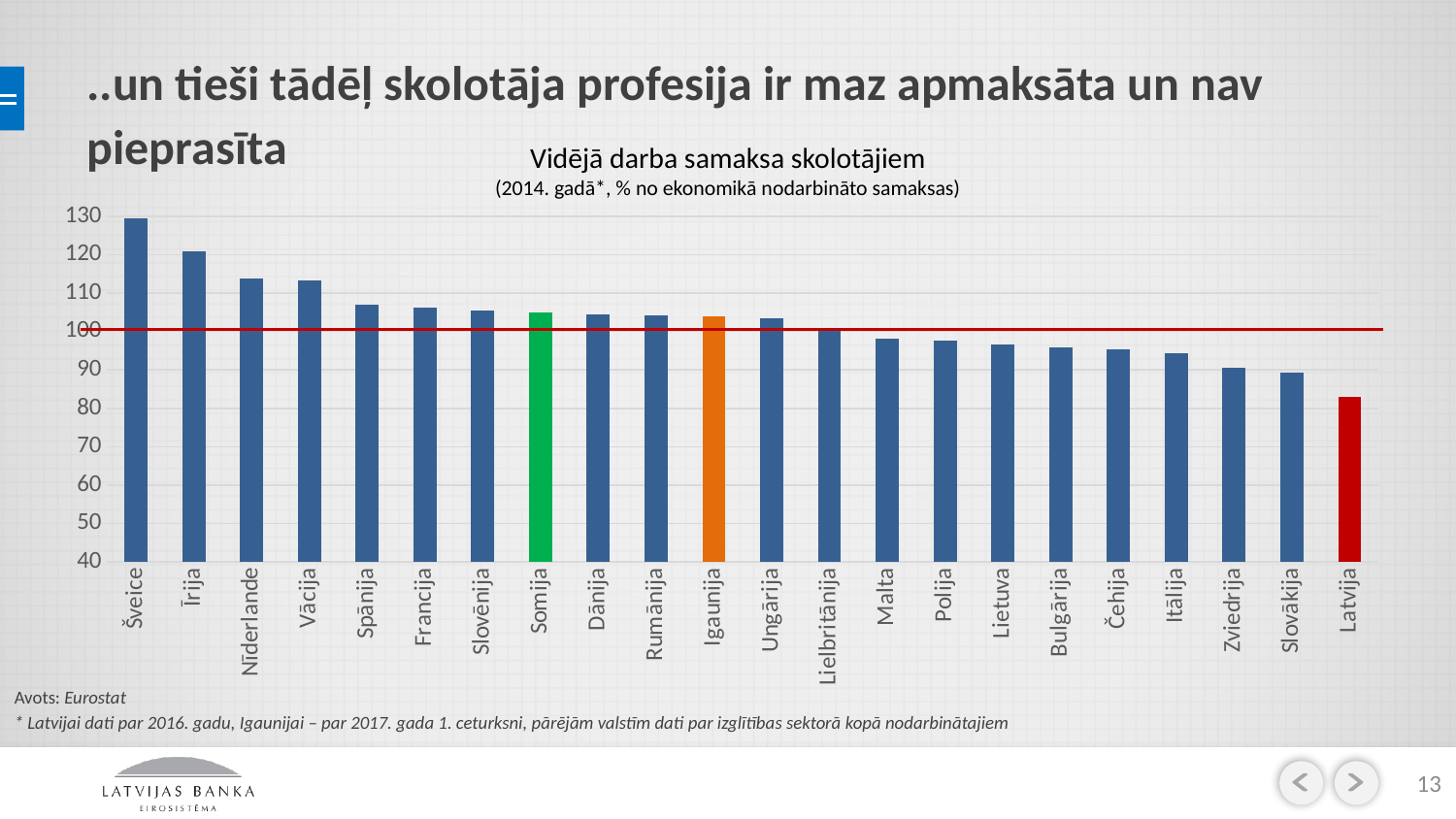
Do the values rise or fall from left to right along the x axis? fall What kind of chart is shown on the slide? bar chart How many countries are shown in the chart? 22 Which country has the highest value in the chart? Šveice Is the value for Šveice greater or less than 120? greater What colour is the bar for Latvija? red Which country has the lowest value in the chart? Latvija Which has a larger value, Īrija or Spānija? Īrija Is the value for Zviedrija greater or less than 100? less Is the value for Vācija greater or less than 110? greater What is the title of the chart? Vidējā darba samaksa skolotājiem